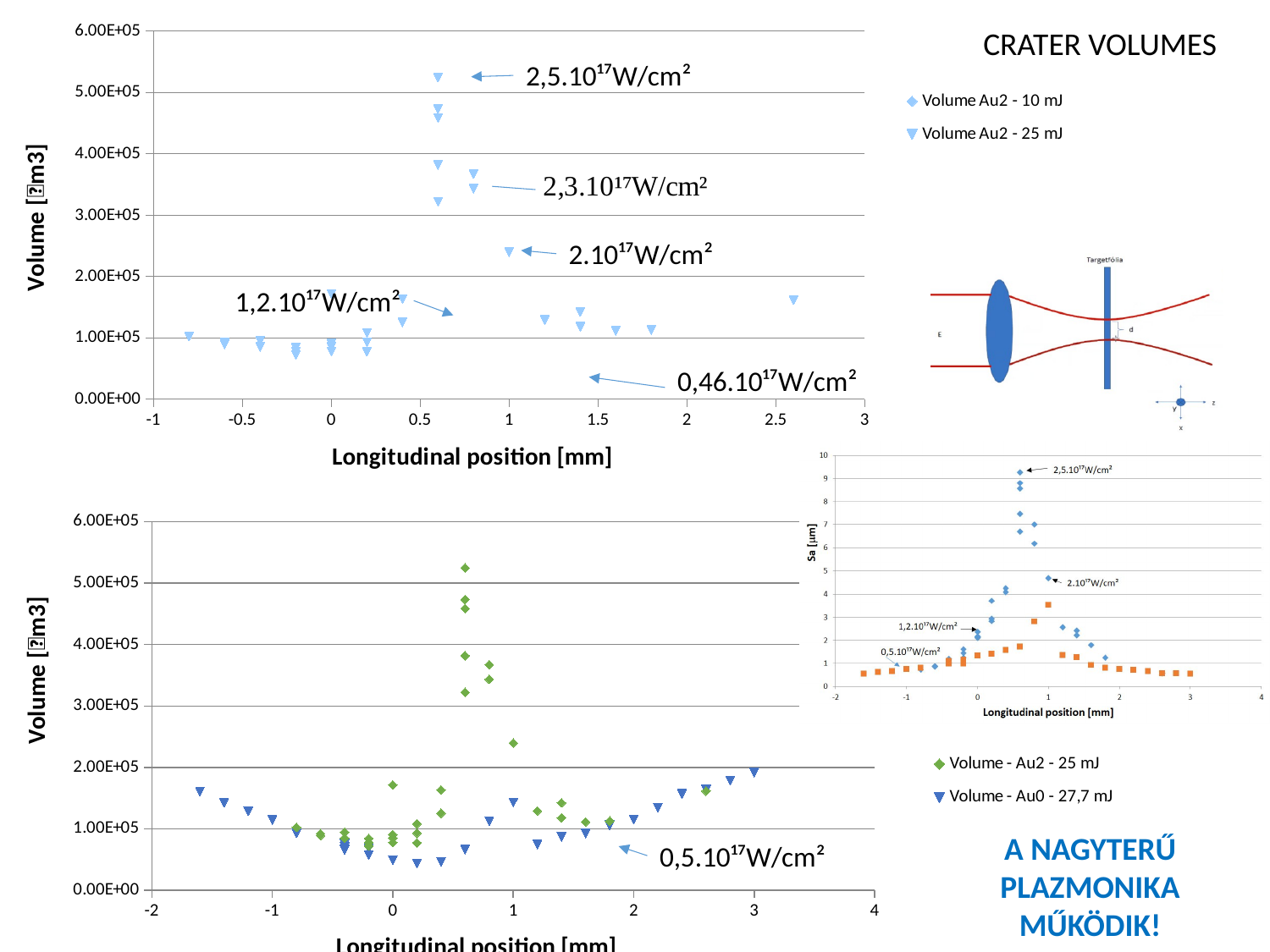
How many series does the legend of the top-left chart list? 2 In the top-left chart, at which longitudinal position (mm) is the highest volume plotted? 0.6 In the top-left chart, which intensity annotation points to the highest cluster of points? 2,5.10¹⁷W/cm² In the small inset chart on the right with y axis 'Sa [µm]', is the highest blue point greater or less than 8? greater In the bottom-left chart, which series has the higher value at longitudinal position 0.6 mm, 'Volume - Au2 - 25 mJ' or 'Volume - Au0 - 27,7 mJ'? Volume - Au2 - 25 mJ In the bottom-left chart, is the highest 'Volume - Au2 - 25 mJ' value greater or less than 5.00E+05? greater What kind of chart is the top-left chart titled with the y axis 'Volume'? scatter chart In the top-left chart, is the highest plotted volume at longitudinal position 0.6 mm greater or less than 5.00E+05? greater How many series does the legend of the bottom-left chart list? 2 What is the x-axis title of the bottom-left chart? Longitudinal position [mm]